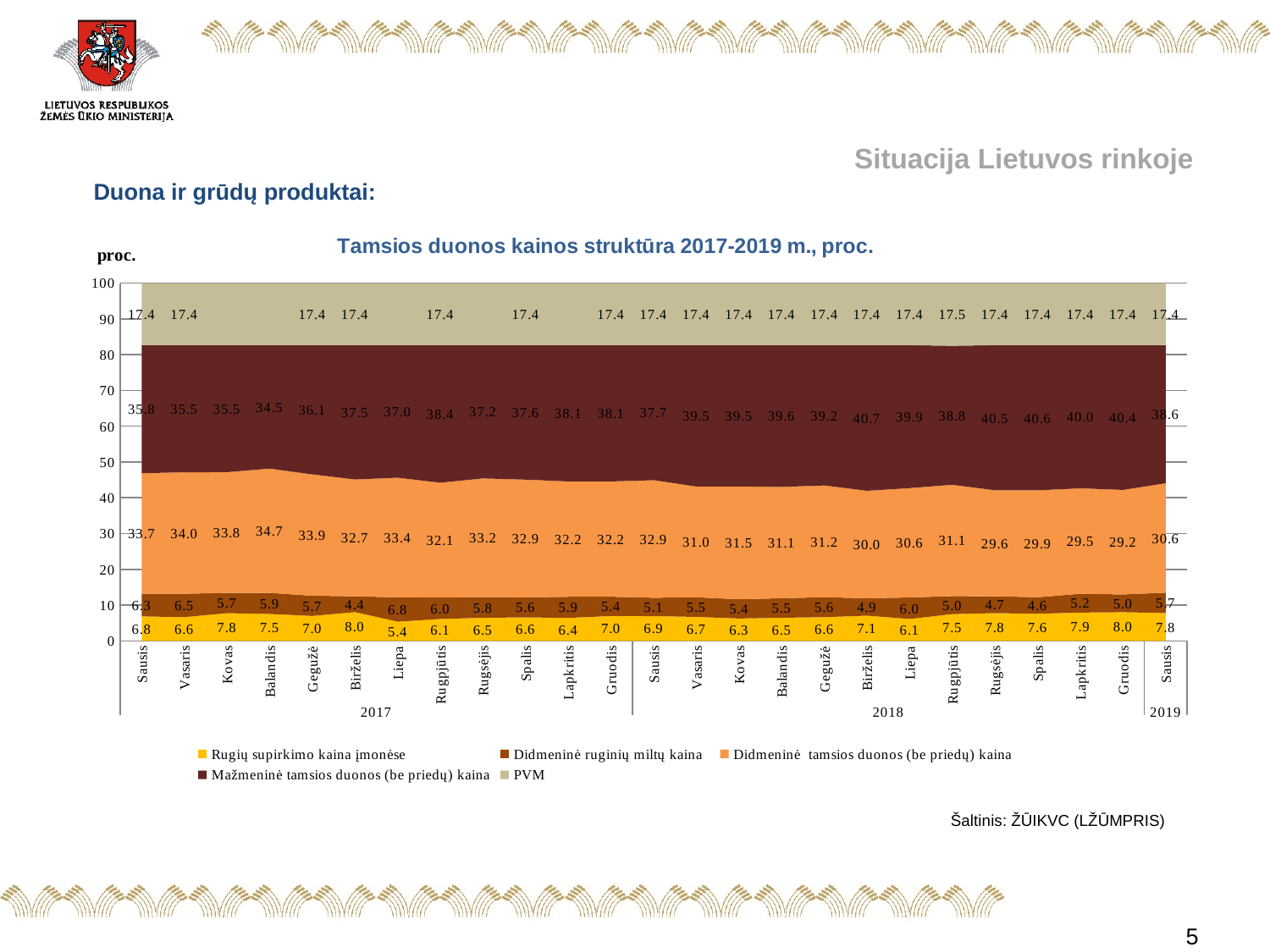
In which month is the Mažmeninė tamsios duonos (be priedų) kaina share the lowest? Balandis 2017 How many series does the legend list? 5 What kind of chart is shown on the slide? Stacked area chart What is the value of Rugių supirkimo kaina įmonėse for Liepa 2017? 5.4 What is the value of PVM for Rugpjūtis 2018? 17.5 What is the value of Mažmeninė tamsios duonos (be priedų) kaina for Birželis 2018? 40.7 What is the value of Didmeninė ruginių miltų kaina for Birželis 2017? 4.4 In which month is the Didmeninė tamsios duonos (be priedų) kaina share the highest? Balandis 2017 Does the Didmeninė tamsios duonos (be priedų) kaina share generally rise or fall from Sausis 2017 to Gruodis 2018? Fall What is the difference between the Mažmeninė tamsios duonos (be priedų) kaina values for Sausis 2017 and Sausis 2019? 2.8 What is the title of the chart? Tamsios duonos kainos struktūra 2017-2019 m., proc. Which is larger for Gruodis 2018: Rugių supirkimo kaina įmonėse or Didmeninė ruginių miltų kaina? Rugių supirkimo kaina įmonėse